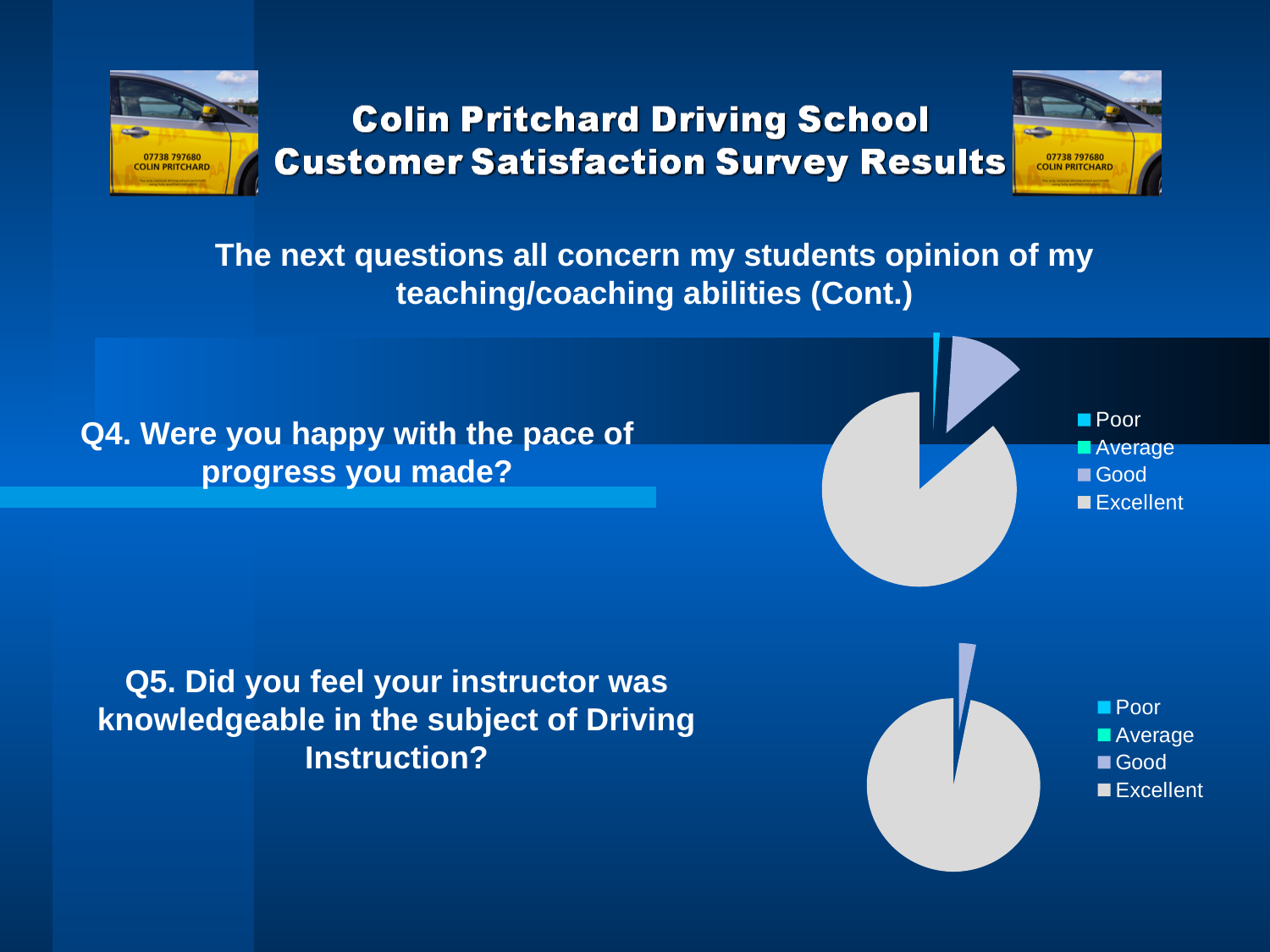
How many entries does the legend of the bottom pie chart (Q5) list? 4 In the bottom pie chart (Q5), which category has the largest slice? Excellent What are the legend entries of the top pie chart (Q4)? Poor, Average, Good, Excellent In the top pie chart (Q4), which slice is larger, Good or Excellent? Excellent In the bottom pie chart (Q5), which category is shown in grey? Excellent What kind of chart is shown next to Q4 (the top chart)? Pie chart Which of the two pie charts has the larger Good slice, the top chart (Q4) or the bottom chart (Q5)? The top chart (Q4) How many entries does the legend of the top pie chart (Q4) list? 4 In the bottom pie chart (Q5), which slice is larger, Excellent or Good? Excellent In the top pie chart (Q4), which category has the largest slice? Excellent What kind of chart is shown next to Q5 (the bottom chart)? Pie chart